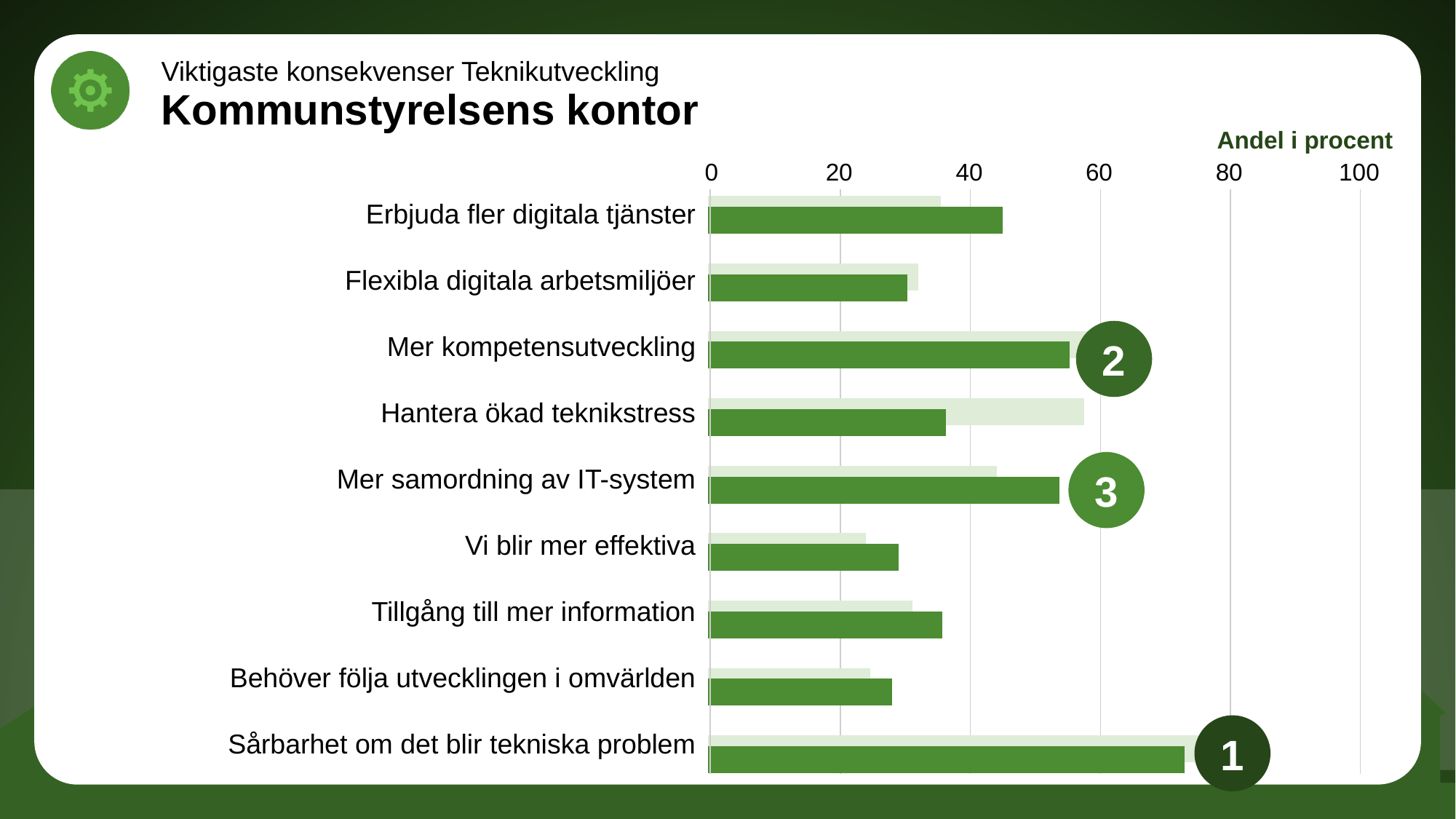
Is the dark green bar for 'Mer kompetensutveckling' greater or less than 40? greater Which category has the longest dark green bar? Sårbarhet om det blir tekniska problem Is the dark green bar for 'Erbjuda fler digitala tjänster' greater or less than 60? less Which category is marked with the circled number 1? Sårbarhet om det blir tekniska problem Is the dark green bar for 'Flexibla digitala arbetsmiljöer' greater or less than 40? less How many categories are listed on the chart? 9 What label is shown above the horizontal axis of the chart? Andel i procent What kind of chart is shown on the slide? bar chart Which has the longer dark green bar, 'Erbjuda fler digitala tjänster' or 'Flexibla digitala arbetsmiljöer'? Erbjuda fler digitala tjänster Which has the longer dark green bar, 'Mer samordning av IT-system' or 'Vi blir mer effektiva'? Mer samordning av IT-system